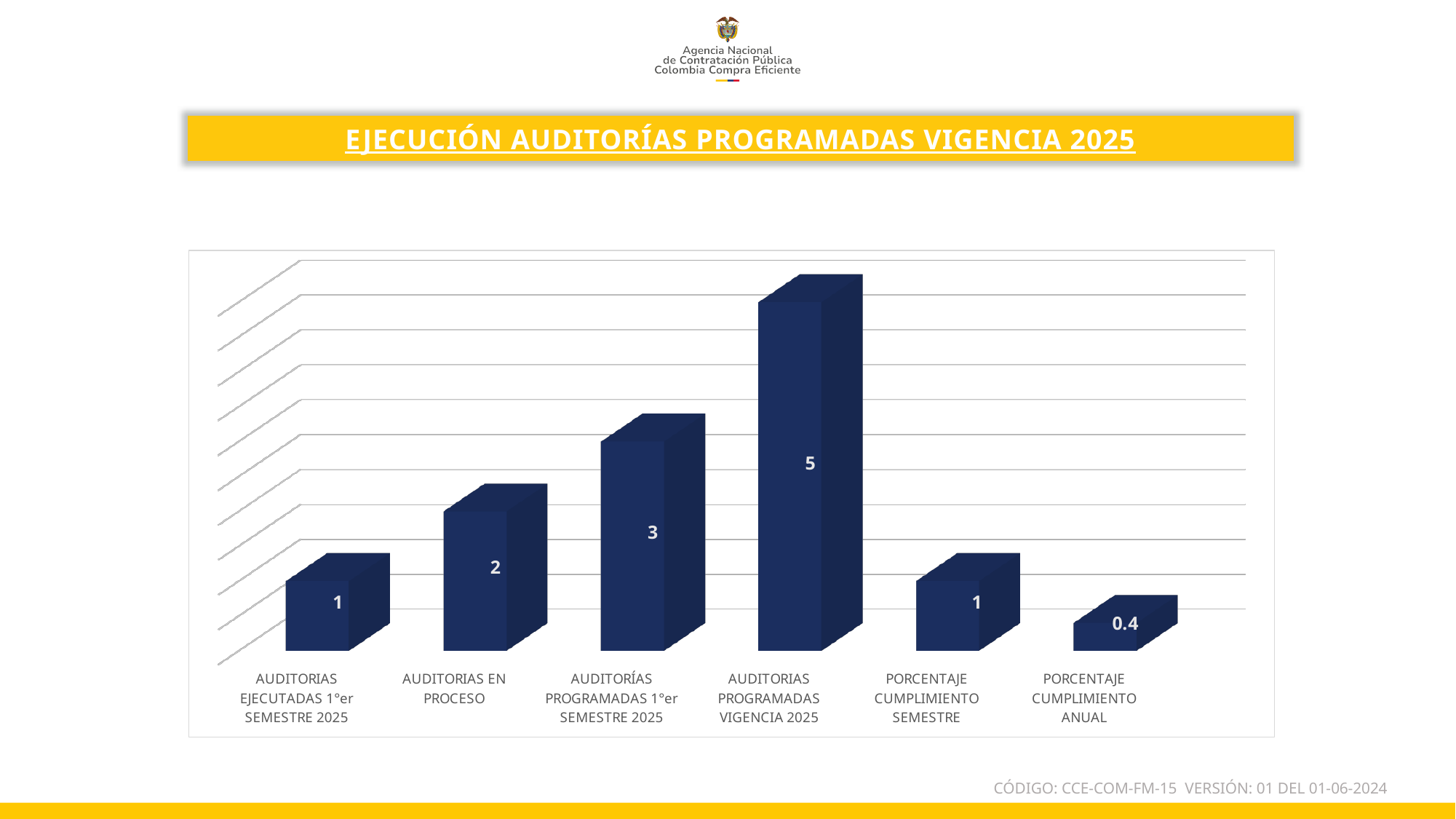
What is the value for AUDITORIAS PROGRAMADAS VIGENCIA 2025? 5 Which is larger, AUDITORIAS EN PROCESO or PORCENTAJE CUMPLIMIENTO SEMESTRE? AUDITORIAS EN PROCESO Which category has the highest value? AUDITORIAS PROGRAMADAS VIGENCIA 2025 What is the title shown above the chart? EJECUCIÓN AUDITORÍAS PROGRAMADAS VIGENCIA 2025 Which category has the lowest value? PORCENTAJE CUMPLIMIENTO ANUAL What is the value for PORCENTAJE CUMPLIMIENTO ANUAL? 0.4 What kind of chart is shown on the slide? Bar chart What is the value for AUDITORIAS EN PROCESO? 2 How many categories are shown in the chart? 6 What is the difference between AUDITORIAS PROGRAMADAS VIGENCIA 2025 and AUDITORÍAS PROGRAMADAS 1°er SEMESTRE 2025? 2 What is the value for AUDITORIAS EJECUTADAS 1°er SEMESTRE 2025? 1 What is the value for AUDITORÍAS PROGRAMADAS 1°er SEMESTRE 2025? 3